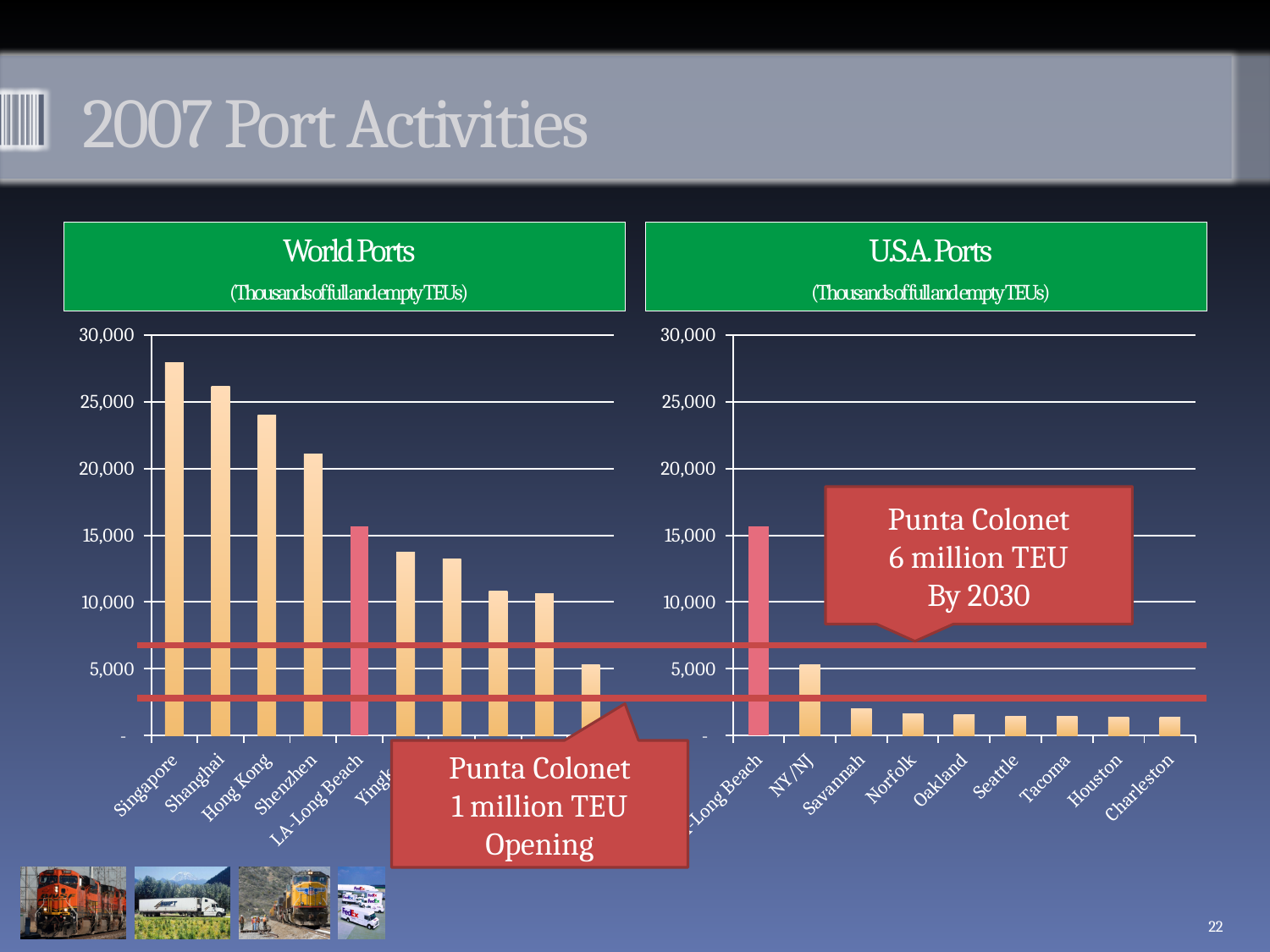
In the World Ports chart, which port has the highest value? Singapore What kind of chart is the World Ports chart? bar chart In the U.S.A. Ports chart, is the value for Savannah greater or less than 5,000? less In the U.S.A. Ports chart, which is larger, the value for NY/NJ or the value for Savannah? NY/NJ In the U.S.A. Ports chart, is the value for Charleston greater or less than 5,000? less How many ports are plotted in the U.S.A. Ports chart? 9 In the U.S.A. Ports chart, which port has the highest value? LA-Long Beach In the U.S.A. Ports chart, do the values rise or fall from left to right? fall In the World Ports chart, is the value for Singapore greater or less than 25,000? greater What unit does the subtitle of the World Ports chart say the values are in? Thousands of full and empty TEUs In the World Ports chart, which is larger, the value for Hong Kong or the value for Shenzhen? Hong Kong